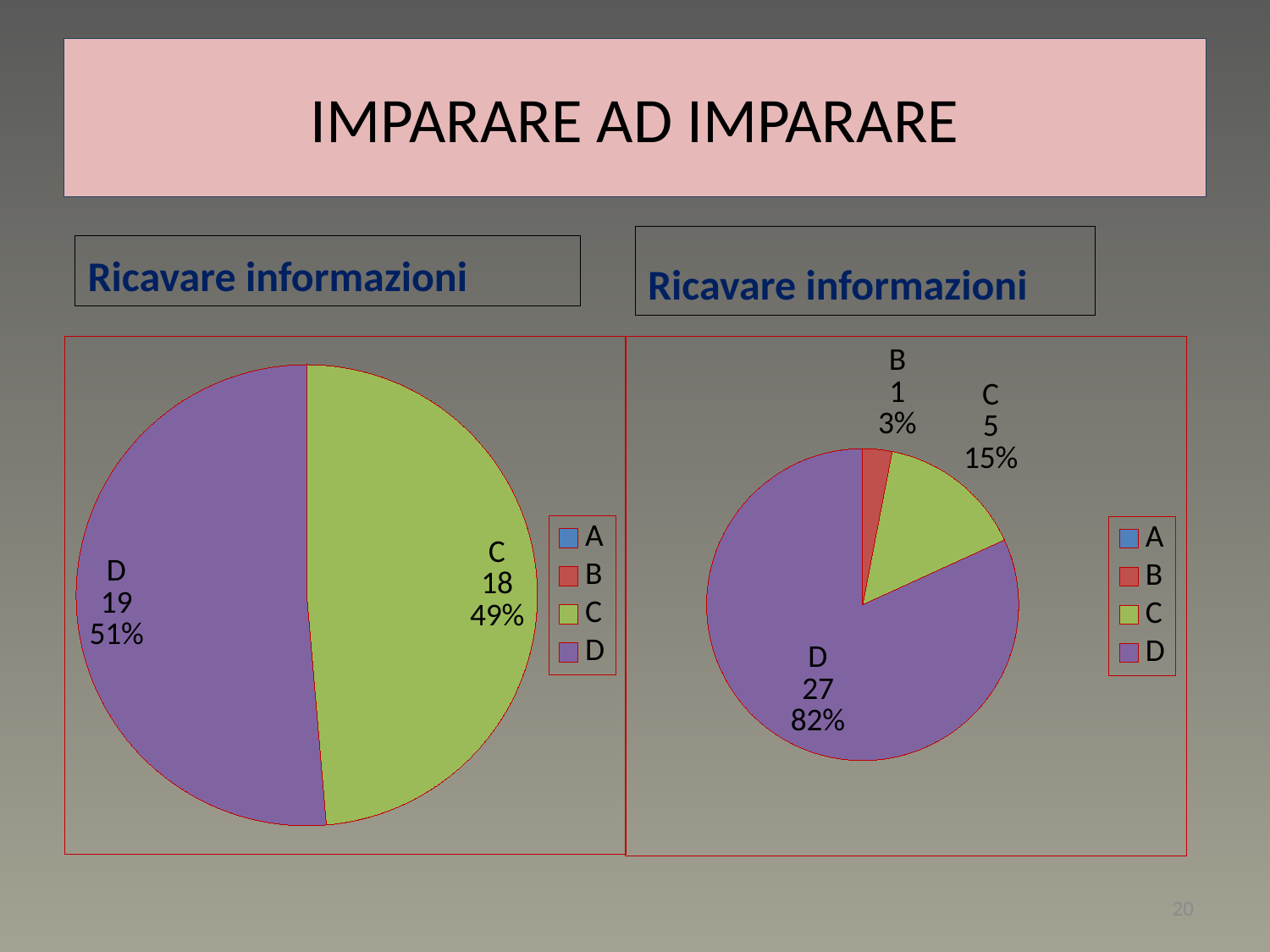
In the left pie chart, what percentage share does category C have? 49% What is the title shown above the left pie chart? Ricavare informazioni In the right pie chart, what is the difference between the values for D and C? 22 In the left pie chart, what is the difference between the values for D and C? 1 In the right pie chart, which category has the largest slice? D In the right pie chart, what value is shown for category B? 1 What type of chart is shown on the left side of the slide? Pie chart In the right pie chart, what percentage share does category C have? 15% In the right pie chart, what value is shown for category D? 27 How many entries does the legend of the right pie chart list? 4 In the left pie chart, what value is shown for category D? 19 In the right pie chart, which labelled category has the smallest slice? B